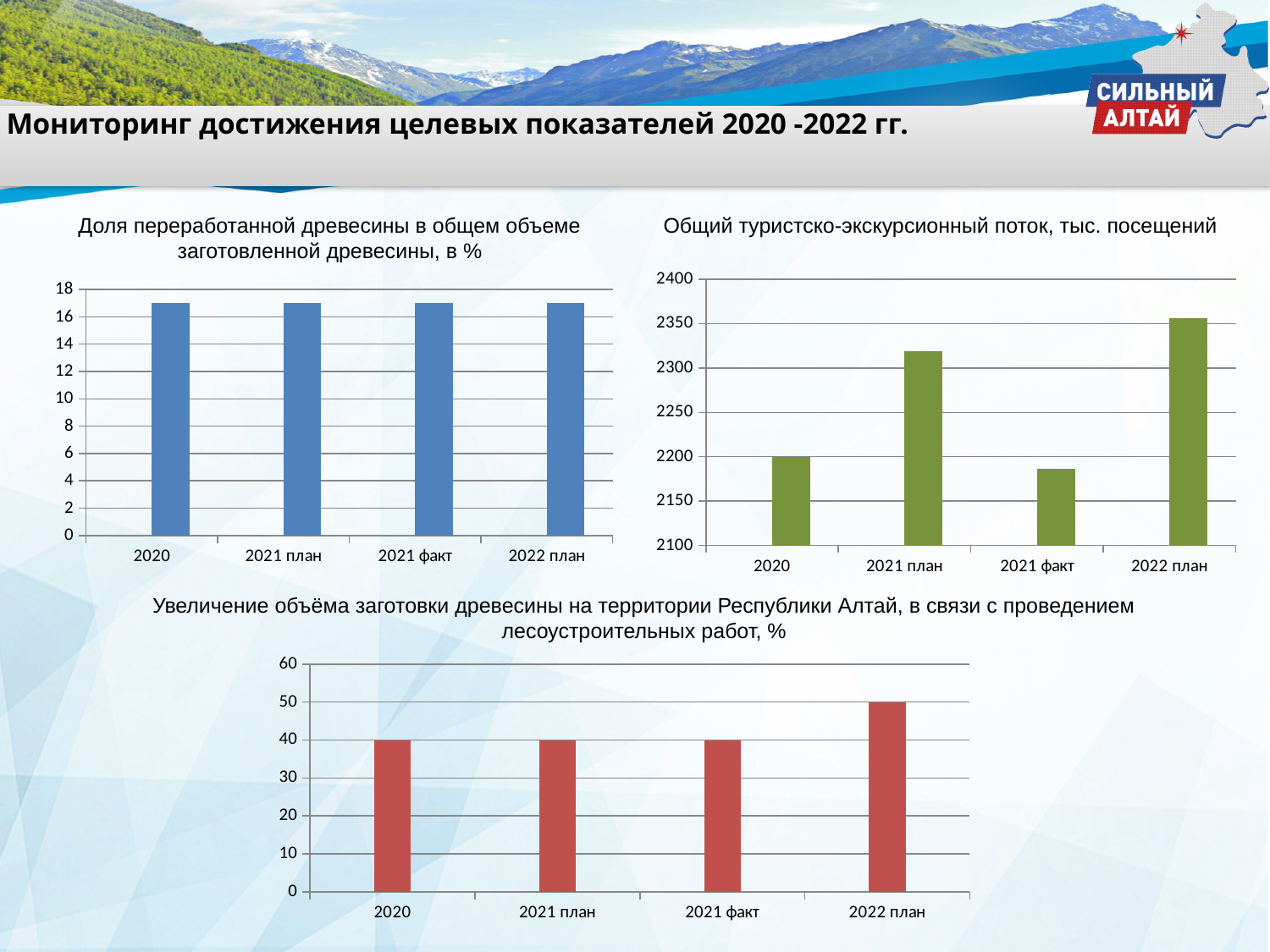
In the chart titled "Увеличение объёма заготовки древесины...", what is the difference between the values for 2022 план and 2021 факт? 10 In the chart titled "Общий туристско-экскурсионный поток, тыс. посещений", is the value for 2021 факт greater or less than 2200? less What kind of chart is the chart titled "Общий туристско-экскурсионный поток, тыс. посещений"? bar chart In the chart titled "Увеличение объёма заготовки древесины...", what is the value for 2021 факт? 40 How many categories are shown on the x axis of the chart titled "Доля переработанной древесины в общем объеме заготовленной древесины, в %"? 4 In the chart titled "Увеличение объёма заготовки древесины...", what is the value for 2022 план? 50 In the chart titled "Общий туристско-экскурсионный поток, тыс. посещений", is the value for 2021 план greater or less than 2300? greater In the chart titled "Увеличение объёма заготовки древесины...", which category has the highest value? 2022 план In the chart titled "Доля переработанной древесины в общем объеме заготовленной древесины, в %", is the value for 2020 greater or less than 16? greater In the chart titled "Общий туристско-экскурсионный поток, тыс. посещений", what is the value for 2020? 2200 In the chart titled "Общий туристско-экскурсионный поток, тыс. посещений", which category has the highest value? 2022 план In the chart titled "Общий туристско-экскурсионный поток, тыс. посещений", which category has the lowest value? 2021 факт